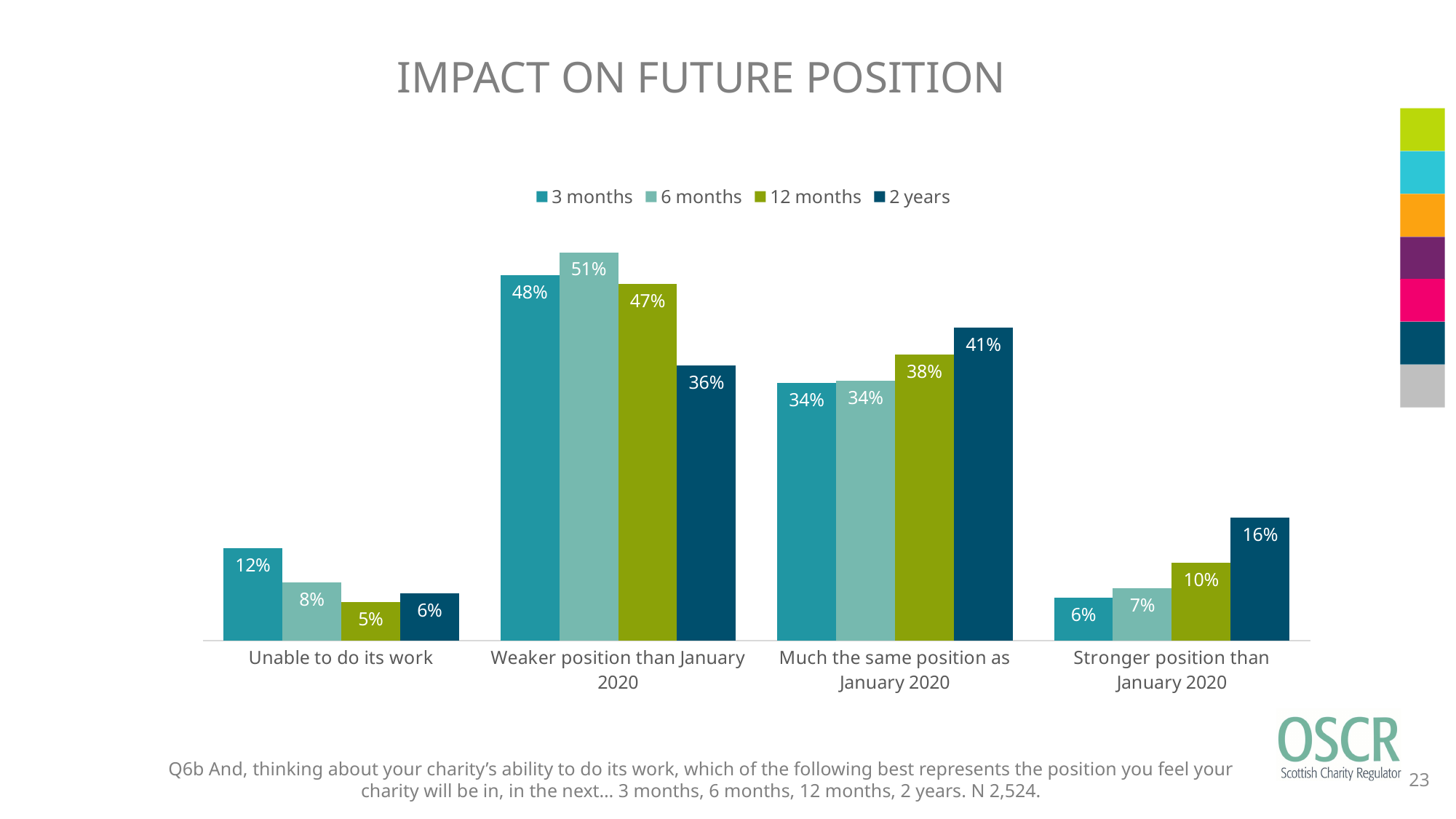
Do the values for the 'Stronger position than January 2020' category rise or fall from '3 months' to '2 years'? Rise What is the value for '2 years' in the 'Stronger position than January 2020' category? 16% How many series does the legend list? 4 Which category has the lowest value for the '12 months' series? Unable to do its work What is the difference between the '3 months' and '2 years' values in the 'Weaker position than January 2020' category? 12% How many categories are shown on the x axis? 4 What kind of chart is shown on the slide? Bar chart What is the title of the chart? IMPACT ON FUTURE POSITION What is the value for '3 months' in the 'Unable to do its work' category? 12% Which category has the highest value for the '2 years' series? Much the same position as January 2020 Which is larger in the 'Much the same position as January 2020' category: the '12 months' value or the '2 years' value? 2 years What is the value for '6 months' in the 'Weaker position than January 2020' category? 51%